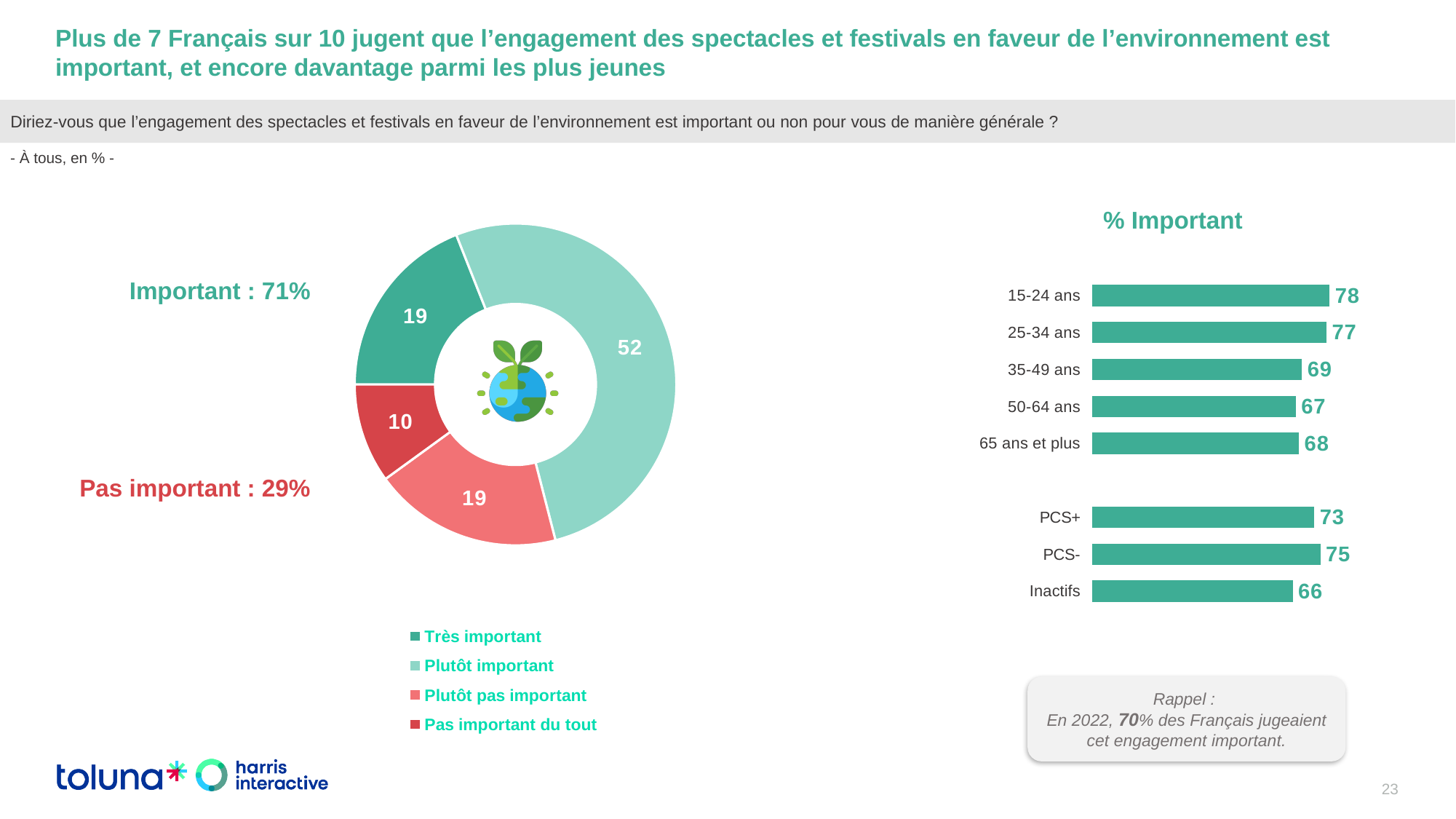
What type of chart is the '% Important' chart on the right? Bar chart In the donut chart, what value is shown for 'Plutôt important'? 52 How many categories does the legend of the donut chart list? 4 How many bars are shown in the '% Important' bar chart? 8 In the '% Important' bar chart, which age group has the highest value? 15-24 ans In the '% Important' bar chart, what is the value for 'Inactifs'? 66 In the '% Important' bar chart, what is the value for '35-49 ans'? 69 In the donut chart, what value is shown for 'Pas important du tout'? 10 In the '% Important' bar chart, which is larger: 'PCS+' or 'PCS-'? PCS- In the donut chart, which category has the largest slice? Plutôt important In the donut chart, which category has the smallest slice? Pas important du tout In the '% Important' bar chart, what is the difference between '15-24 ans' and '50-64 ans'? 11